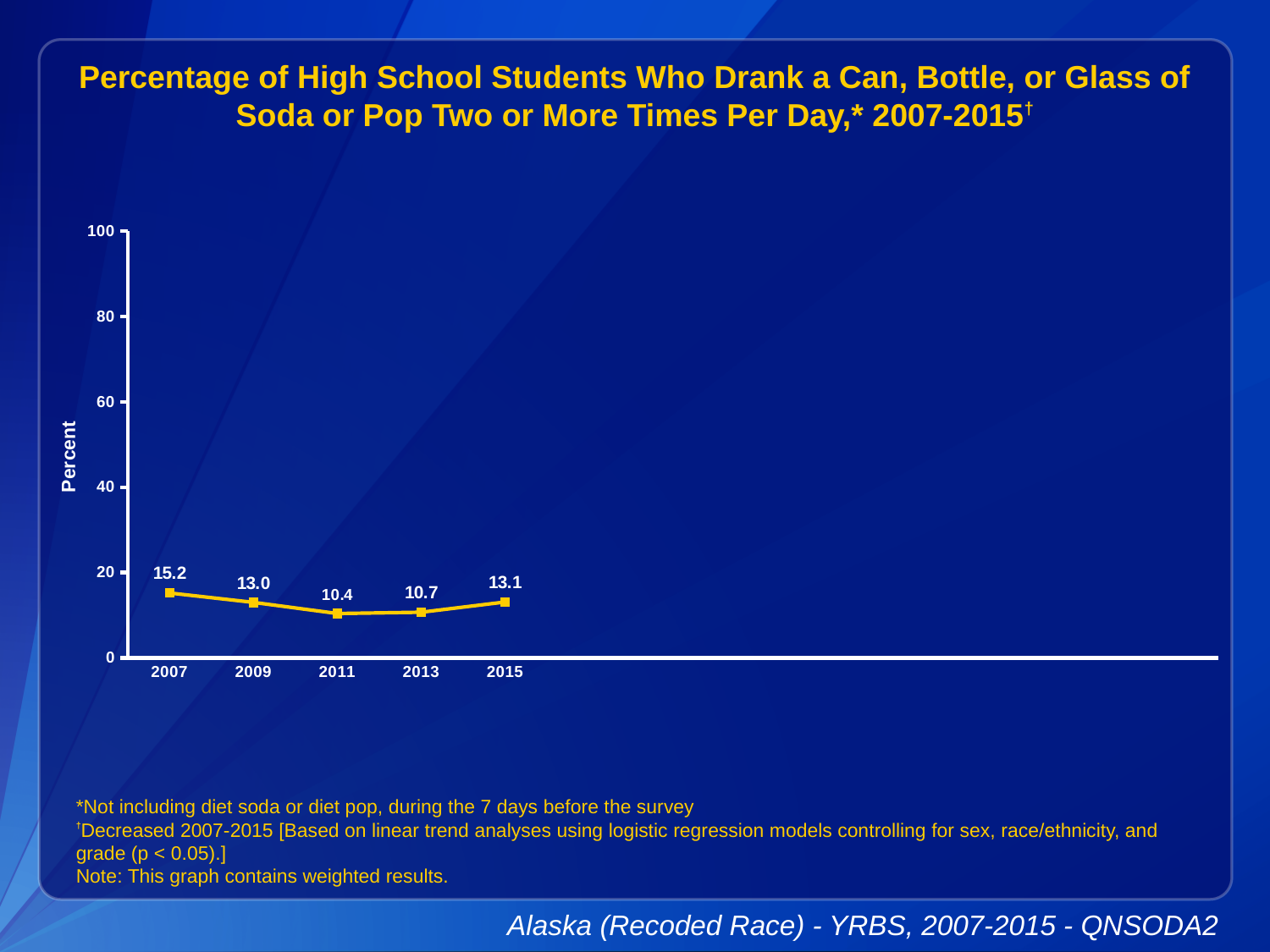
What is the value plotted for 2015? 13.1 What percentage of high school students drank soda or pop two or more times per day in 2007? 15.2 What is the label on the y axis? Percent How many years are plotted on the chart? 5 Which is larger, the value for 2009 or the value for 2013? 2009 Is the value for 2007 greater or less than 20? less Which year has the highest value on the chart? 2007 What is the difference between the 2007 value and the 2011 value? 4.8 Does the value rise or fall from 2007 to 2011? fall What is the value plotted for 2011? 10.4 Which year has the lowest value on the chart? 2011 What kind of chart is shown on the slide? line chart